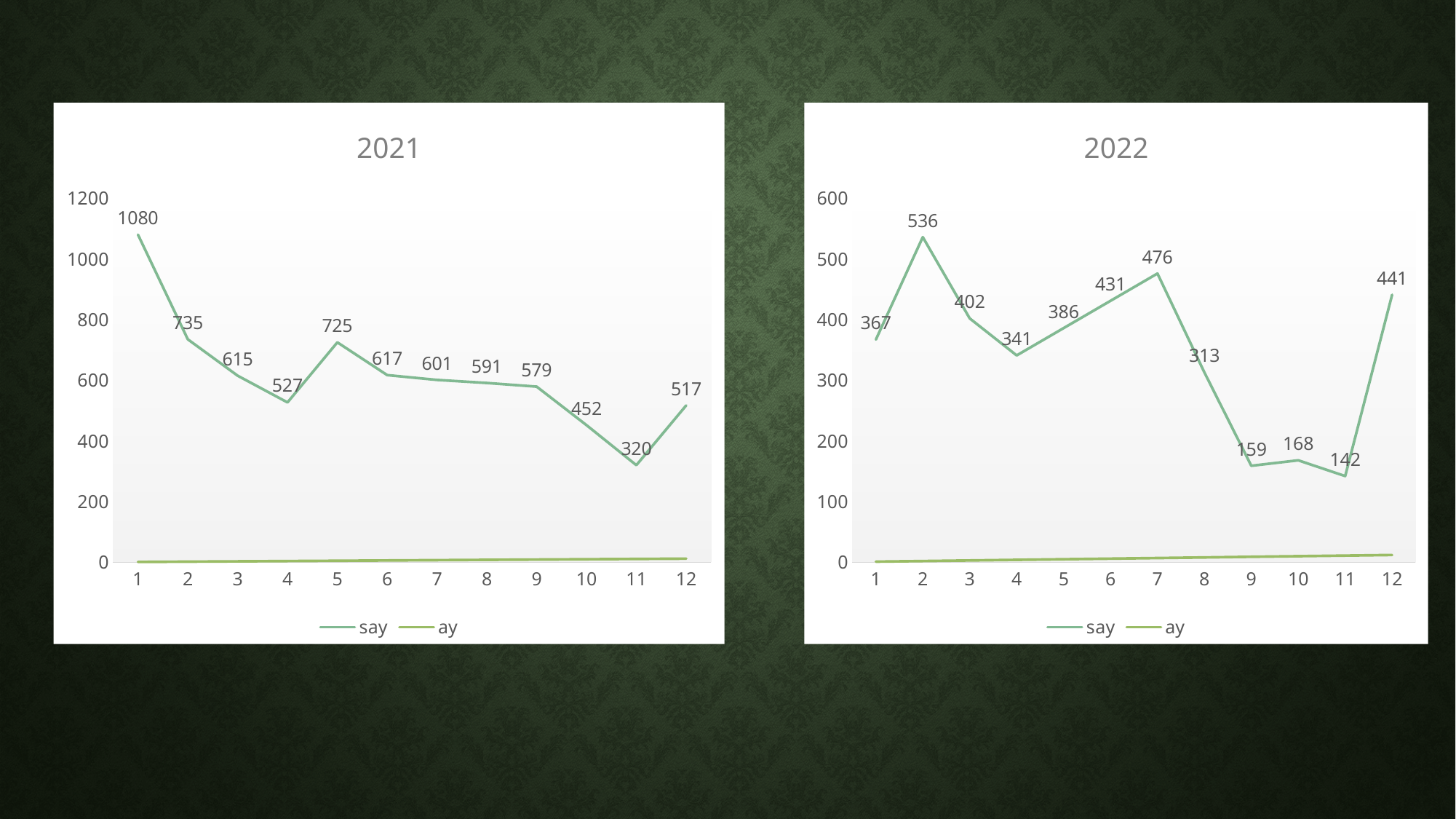
In the 2022 chart, which is larger: the 'say' value at point 12 or at point 3? point 12 In the 2022 chart, what is the difference between the 'say' values at point 2 and point 1? 169 In the 2021 chart, what is the value of the 'say' series at point 11? 320 In the 2021 chart, at which x-axis point is the 'say' series highest? 1 What type of chart is the 2021 chart? line chart In the 2022 chart, at which x-axis point is the 'say' series lowest? 11 In the 2021 chart, what is the difference between the 'say' values at point 5 and point 4? 198 In the 2022 chart, what is the value of the 'say' series at point 7? 476 In the 2021 chart, at which x-axis point is the 'say' series lowest? 11 How many series does the legend of the 2022 chart list? 2 In the 2021 chart, what is the value of the 'say' series at point 1? 1080 In the 2022 chart, at which x-axis point is the 'say' series highest? 2